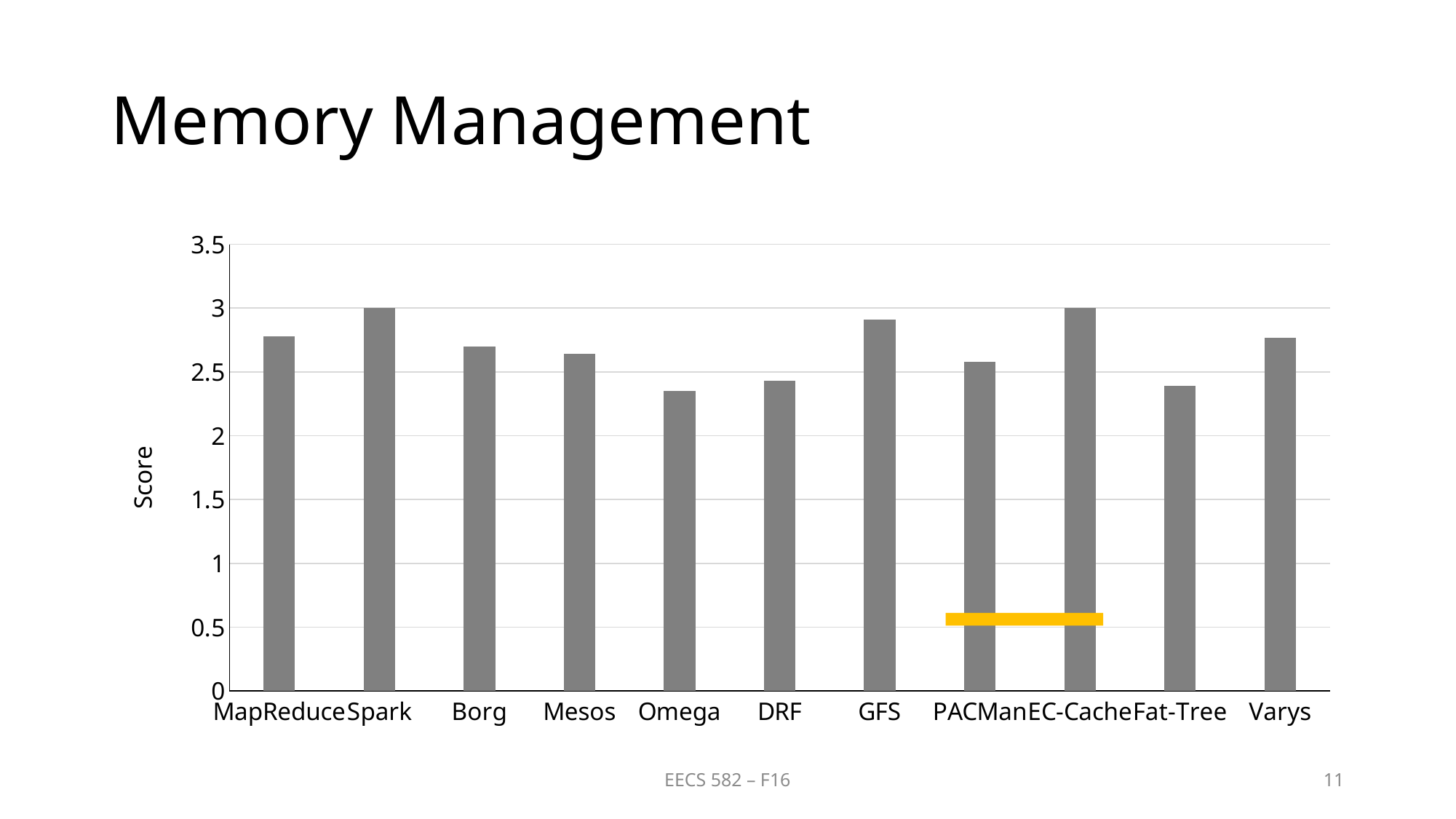
What is the score for Spark? 3 Which has a higher score, GFS or DRF? GFS Is the value for MapReduce greater or less than 2.5? greater Is the value for Omega greater or less than 2.5? less Is the value for GFS greater or less than 2.5? greater Which has a higher score, Spark or Omega? Spark How many categories (systems) are plotted on the x axis? 11 What is the score for EC-Cache? 3 What type of chart is shown on the slide? bar chart What is the label on the y axis? Score What is the title of the slide containing the chart? Memory Management